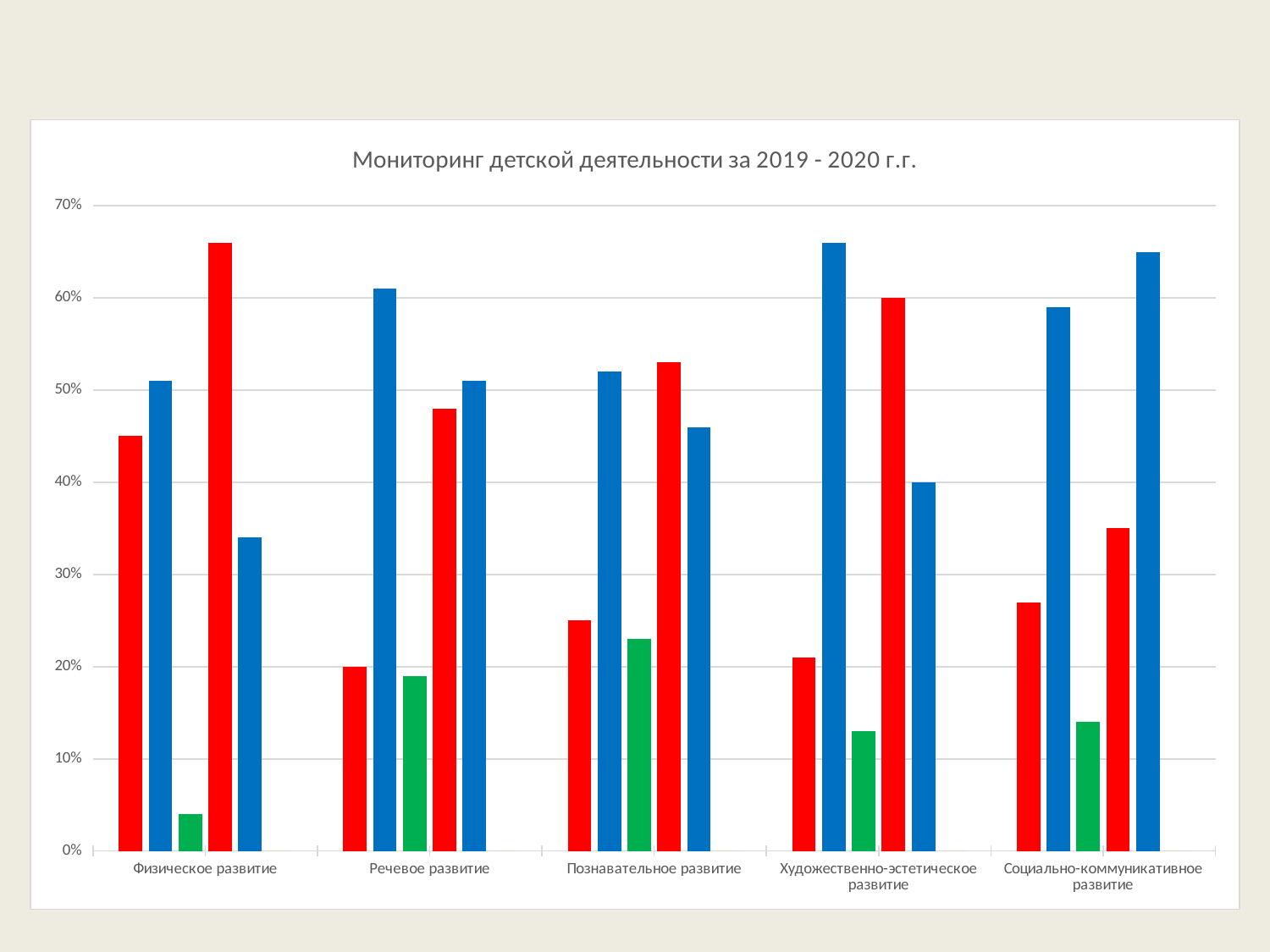
In the category Физическое развитие, is the first red bar or the first blue bar taller? the first blue bar Is the value of the last blue bar for Социально-коммуникативное развитие greater or less than 60%? greater What kind of chart is shown on the slide? bar chart How many categories are shown along the x axis of the chart? 5 Is the value of the green bar for Познавательное развитие greater or less than 20%? greater How many bars are plotted for each category in the chart? 5 Which category has the tallest green bar? Познавательное развитие Is the value of the second red bar for Физическое развитие greater or less than 60%? greater Which category has the shortest green bar? Физическое развитие What is the title of the chart? Мониторинг детской деятельности за 2019 - 2020 г.г.